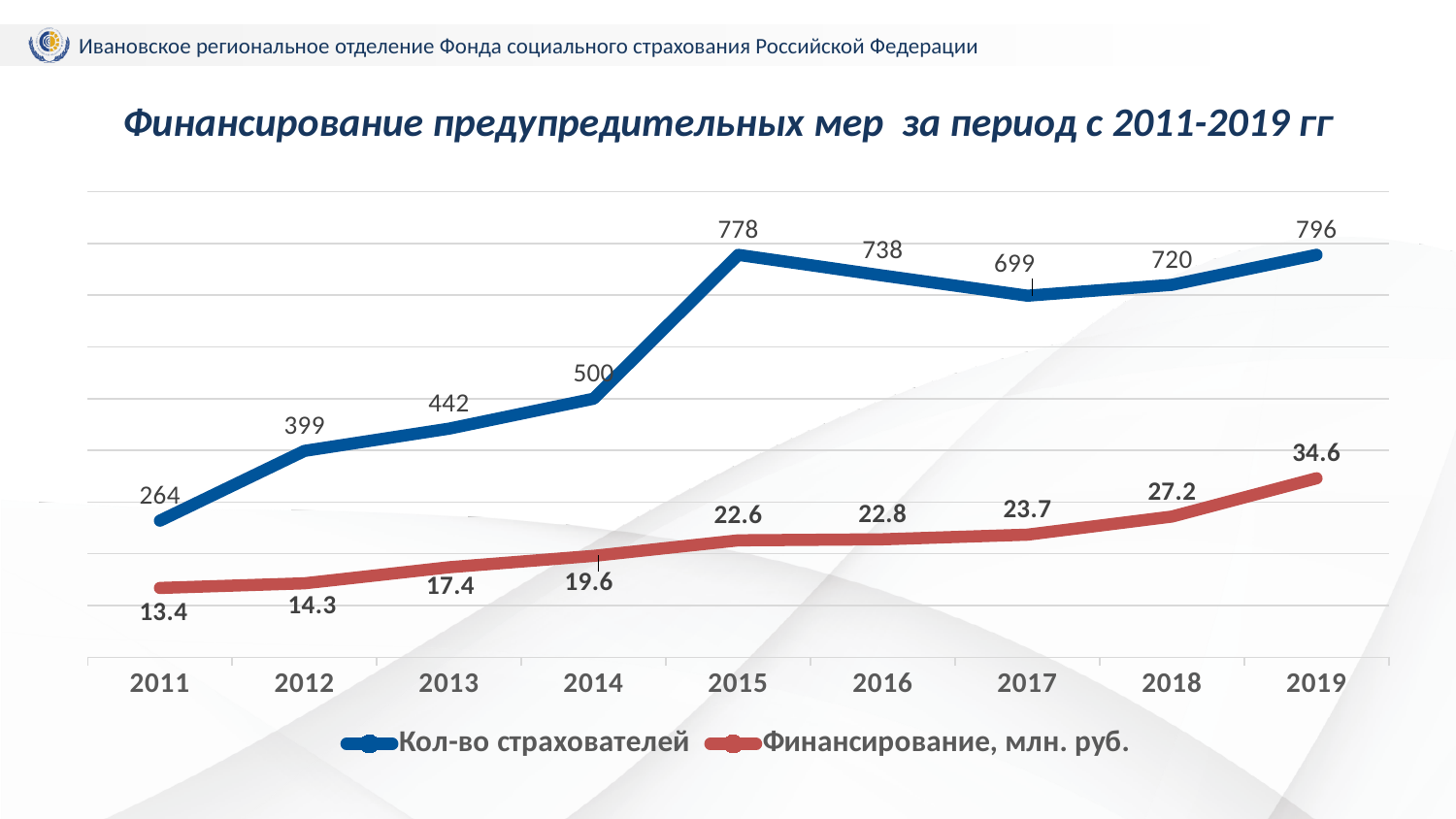
What is the value of 'Финансирование, млн. руб.' in 2019? 34.6 What is the difference between 'Кол-во страхователей' in 2015 and in 2014? 278 How many years are shown on the x axis? 9 What is the difference between 'Финансирование, млн. руб.' in 2019 and in 2018? 7.4 How many series does the legend list? 2 What is the value of 'Кол-во страхователей' in 2011? 264 In which year is 'Кол-во страхователей' the highest? 2019 What type of chart is shown on the slide? line chart Which year has a higher value of 'Кол-во страхователей': 2016 or 2017? 2016 What is the value of 'Кол-во страхователей' in 2015? 778 Does 'Финансирование, млн. руб.' generally rise or fall from 2011 to 2019? rise In which year is 'Финансирование, млн. руб.' the lowest? 2011